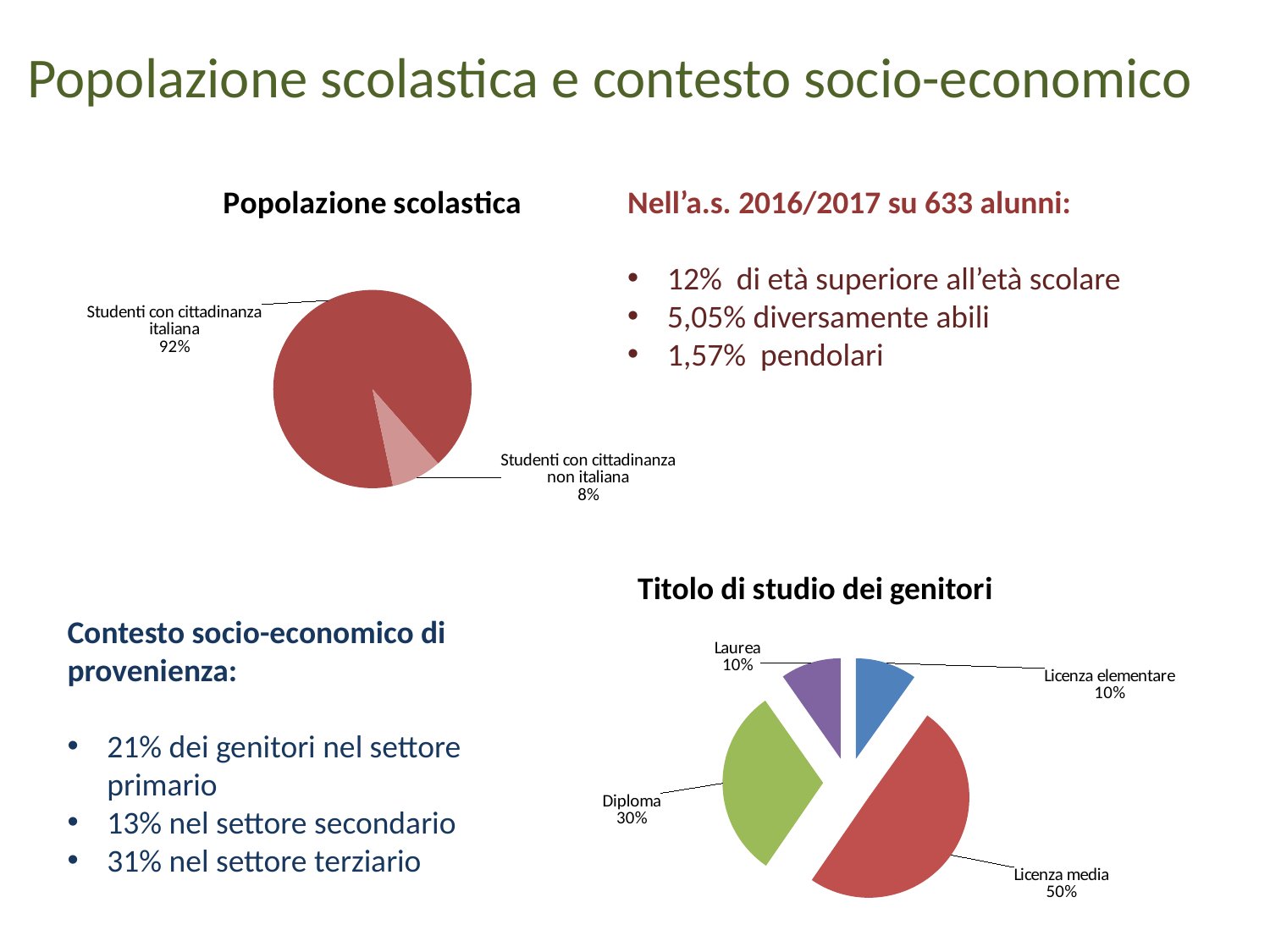
In the 'Popolazione scolastica' chart, what share of students have Italian citizenship (Studenti con cittadinanza italiana)? 92% In the 'Titolo di studio dei genitori' chart, what share of parents have a Laurea? 10% How many slices does the 'Popolazione scolastica' pie chart have? 2 In the 'Titolo di studio dei genitori' chart, what share of parents have a Diploma? 30% What kind of chart is 'Popolazione scolastica'? Pie chart In the 'Titolo di studio dei genitori' chart, what is the difference in percentage points between Licenza media and Diploma? 20 percentage points How many categories are shown in the 'Titolo di studio dei genitori' pie chart? 4 In the 'Popolazione scolastica' chart, what is the difference in percentage points between students with Italian citizenship and students with non-Italian citizenship? 84 percentage points In the 'Titolo di studio dei genitori' chart, which category has the largest share? Licenza media In the 'Titolo di studio dei genitori' chart, what share of parents have a Licenza media? 50% In the 'Titolo di studio dei genitori' chart, which is larger: Diploma or Licenza elementare? Diploma In the 'Popolazione scolastica' chart, what share of students have non-Italian citizenship (Studenti con cittadinanza non italiana)? 8%